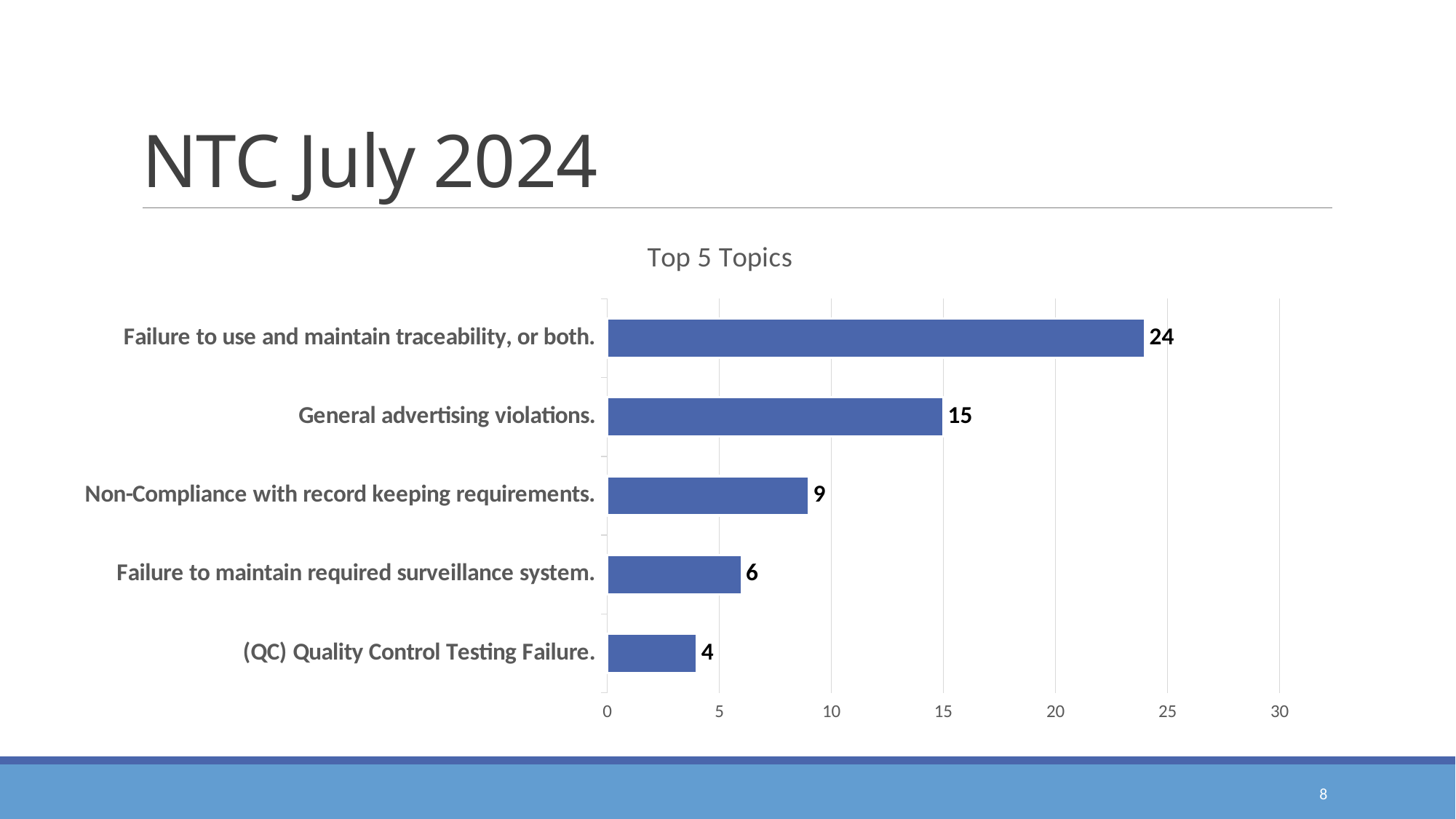
How many categories are shown in the chart? 5 What is the title of the chart? Top 5 Topics Which category has the lowest value? (QC) Quality Control Testing Failure. Which is larger: the value for "Failure to maintain required surveillance system." or "(QC) Quality Control Testing Failure."? Failure to maintain required surveillance system. What is the value for "Non-Compliance with record keeping requirements."? 9 What kind of chart is shown on the slide? Bar chart What is the value for "(QC) Quality Control Testing Failure."? 4 Is the value for "General advertising violations." greater or less than 10? greater What is the difference between the values for "Failure to use and maintain traceability, or both." and "General advertising violations."? 9 Which category has the highest value? Failure to use and maintain traceability, or both. What is the value for "Failure to use and maintain traceability, or both."? 24 What is the value for "General advertising violations."? 15